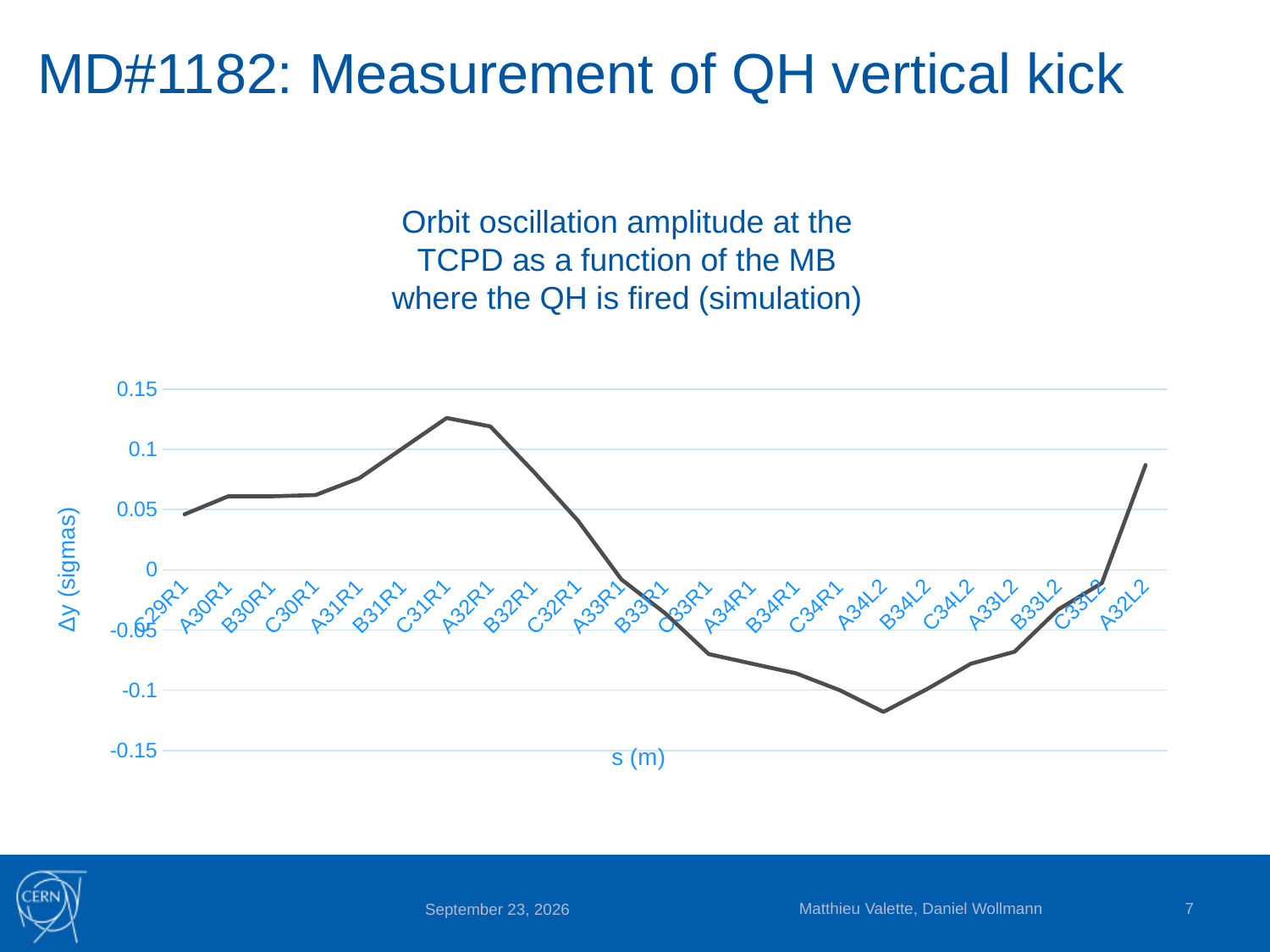
Which has the larger value, C31R1 or A34L2? C31R1 Is the value for B31R1 greater or less than 0.05? greater What kind of chart is shown on the slide? line chart Is the value for A32L2 greater or less than 0.05? greater What is the label of the vertical axis? Δy (sigmas) Is the value for C31R1 greater or less than 0.1? greater At which MB position does the orbit oscillation amplitude reach its highest value? C31R1 Do the values rise or fall along the x axis from C31R1 to A34L2? fall How many MB positions (categories) are plotted along the x axis? 23 At which MB position does the orbit oscillation amplitude reach its lowest value? A34L2